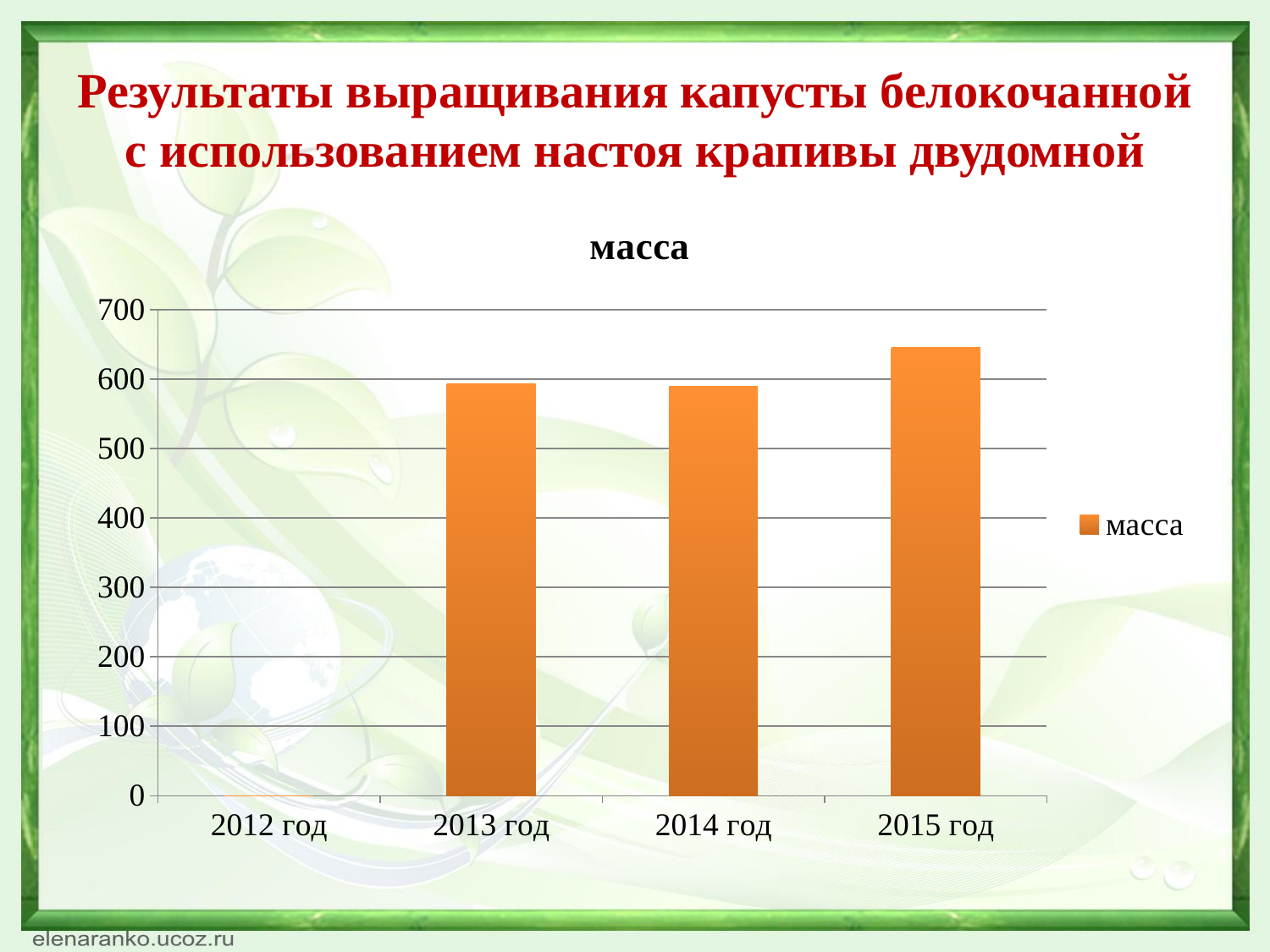
Is the value for 2012 год greater or less than 100? less Which year has the lowest value in the chart? 2012 год How many categories are shown on the x axis of the chart? 4 Which year has the highest value in the chart? 2015 год Which is larger, the value for 2015 год or the value for 2014 год? 2015 год What is the name of the series shown in the legend? масса Is the value for 2014 год greater or less than 500? greater Is the value for 2013 год greater or less than 500? greater How many series does the chart legend list? 1 What kind of chart is shown on the slide? bar chart What is the title of the chart? масса